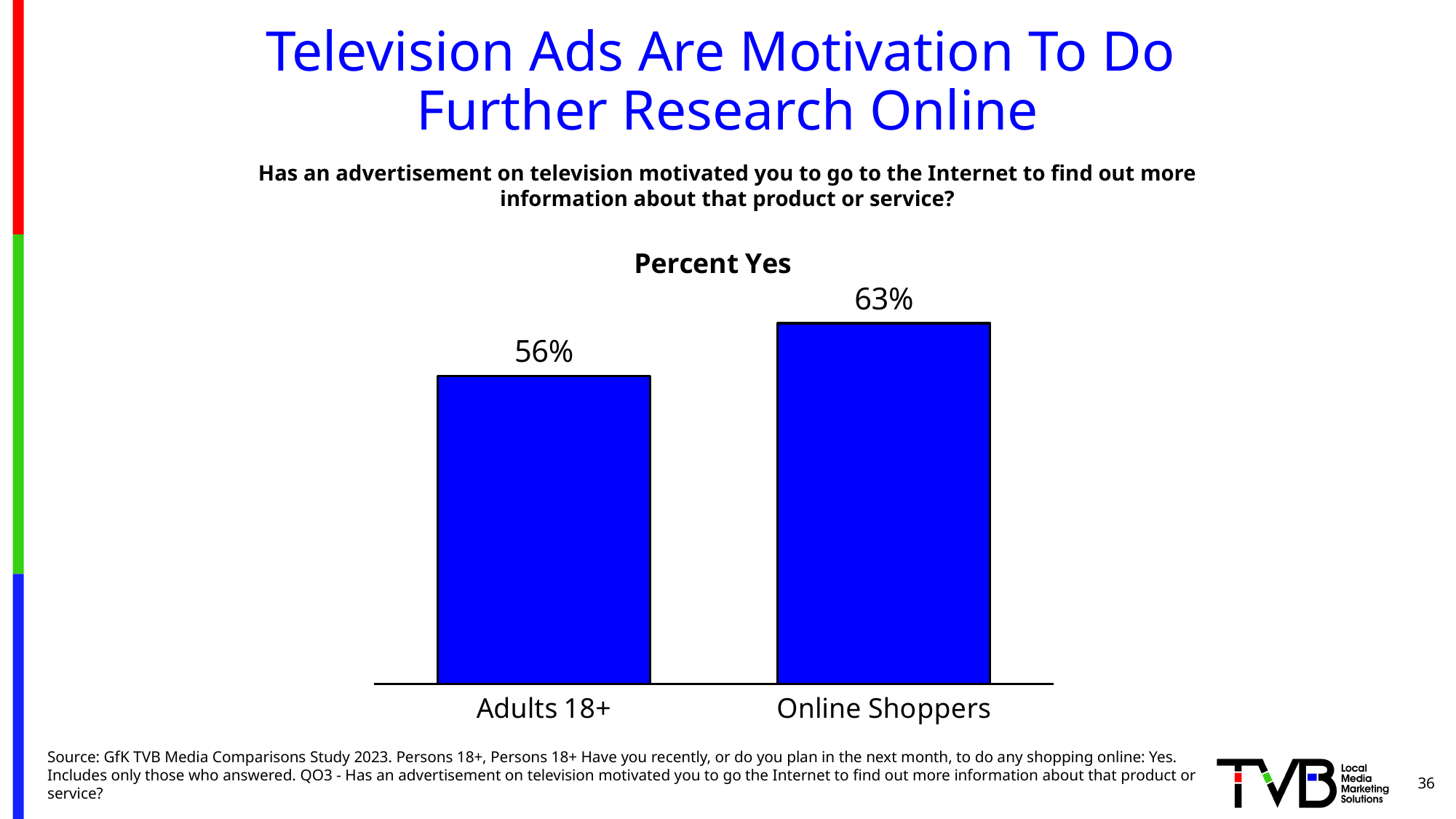
What is the Percent Yes value for Online Shoppers? 63% What is the Percent Yes value for Adults 18+? 56% Which category has the highest Percent Yes value? Online Shoppers What is the difference in Percent Yes between Online Shoppers and Adults 18+? 7% How many categories are shown in the chart? 2 Which category has the lowest Percent Yes value? Adults 18+ What colour are the bars in the chart? Blue Which is larger, the Percent Yes for Adults 18+ or for Online Shoppers? Online Shoppers What kind of chart is shown on the slide? Bar chart What is the title of the chart? Percent Yes